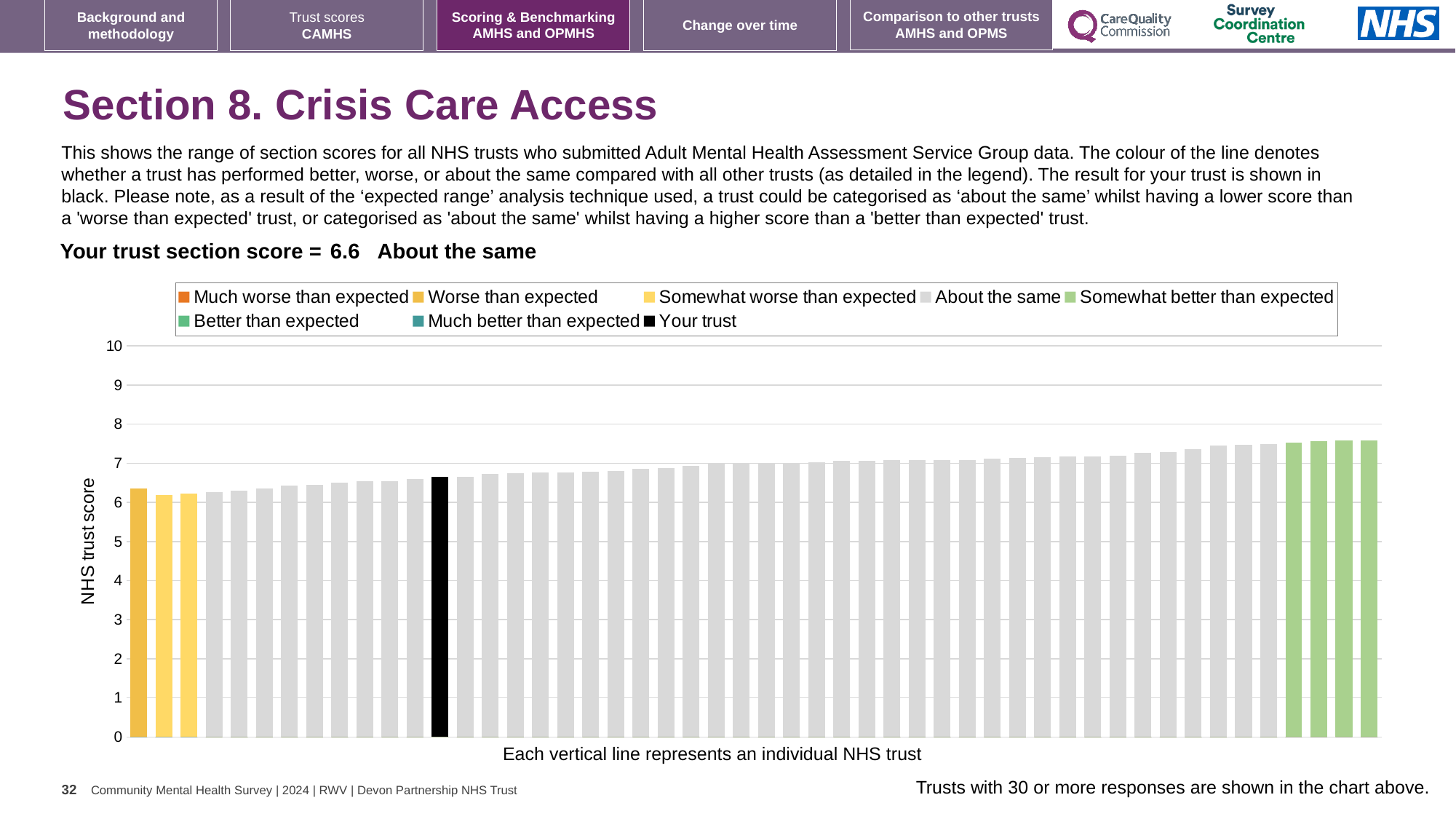
What is the section score for your trust shown on the slide? 6.6 How many bars are coloured green (somewhat better than expected)? 4 Is the value of the tallest bar greater or less than 8? less Is the value of the shortest bar greater or less than 6? greater Do the bar values rise or fall from left to right along the x axis? rise Is the value of the black bar (your trust) greater or less than 7? less What colour does the legend use for 'Your trust'? black How many entries does the chart legend list? 8 What is the label on the vertical axis of the chart? NHS trust score Is the orange bar (worse than expected) taller or shorter than the black bar (your trust)? shorter Which category is your trust's section score placed in? About the same What kind of chart is shown on the slide? bar chart